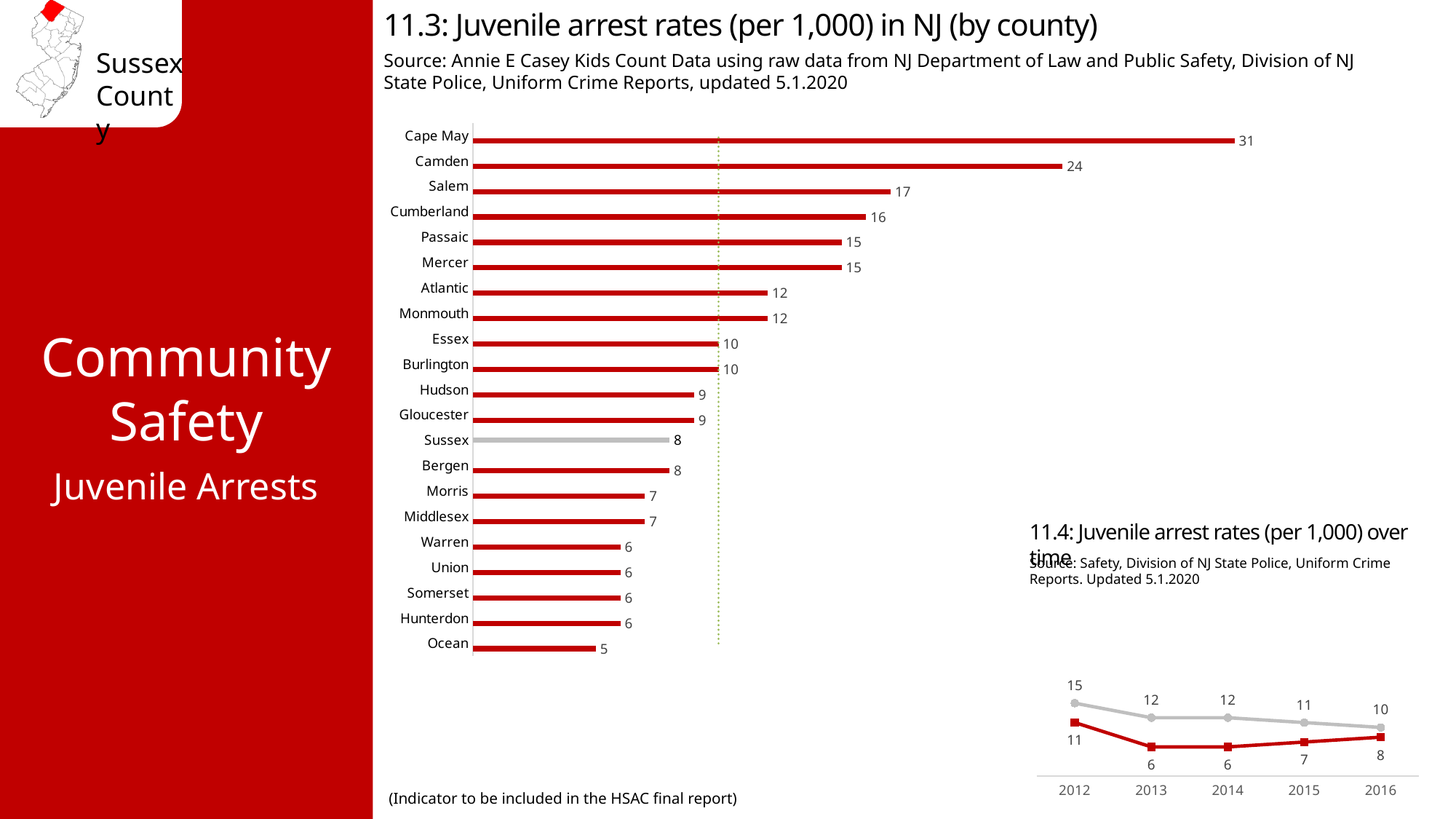
In chart 11.3, which county has the lowest juvenile arrest rate? Ocean In chart 11.4, what is the value of the grey line in 2012? 15 In chart 11.4, what is the value of the red line in 2013? 6 In chart 11.3, which county has the highest juvenile arrest rate? Cape May In chart 11.3, how many counties are shown? 21 In chart 11.3, which county has a higher juvenile arrest rate, Salem or Atlantic? Salem In chart 11.3, what is the difference between the juvenile arrest rates of Cape May and Camden? 7 In chart 11.3, what is the juvenile arrest rate for Sussex County? 8 In chart 11.3, what is the juvenile arrest rate for Cumberland County? 16 In chart 11.4, how many years are plotted on the x axis? 5 In chart 11.4, does the grey line rise or fall from 2012 to 2016? Fall What kind of chart is chart 11.3? Bar chart